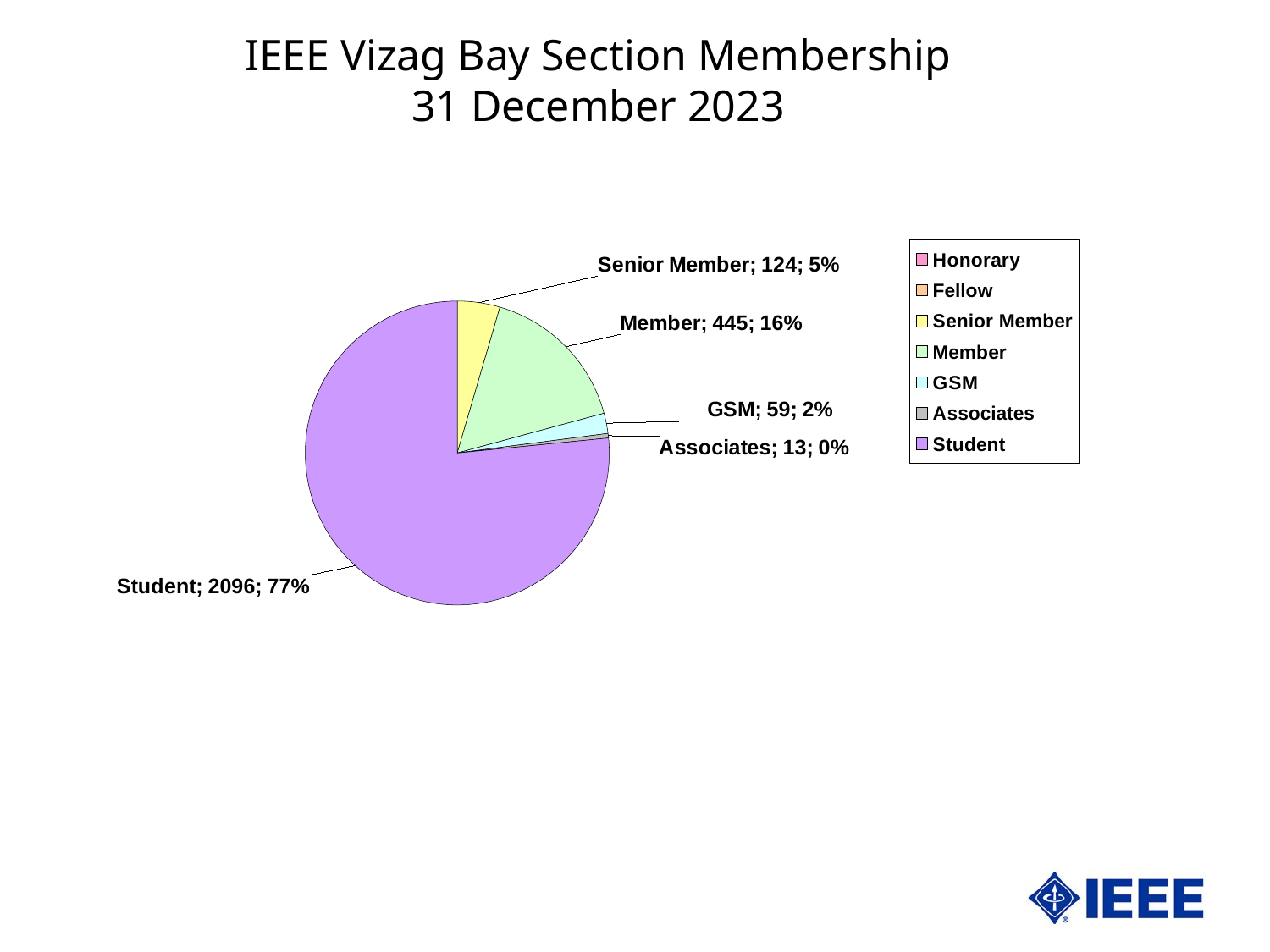
What share of the pie does the Student slice represent? 77% What is the difference between the Member and Senior Member values? 321 What is the value for GSM? 59 How many Senior Members are shown? 124 Which of the labelled slices has the smallest value? Associates How many members are in the Student category? 2096 How many members are in the Member category? 445 Which category has the largest slice of the pie? Student What is the value for Associates? 13 How many entries does the legend list? 7 What kind of chart is shown on the slide? pie chart What percentage of the pie is the Member slice? 16%